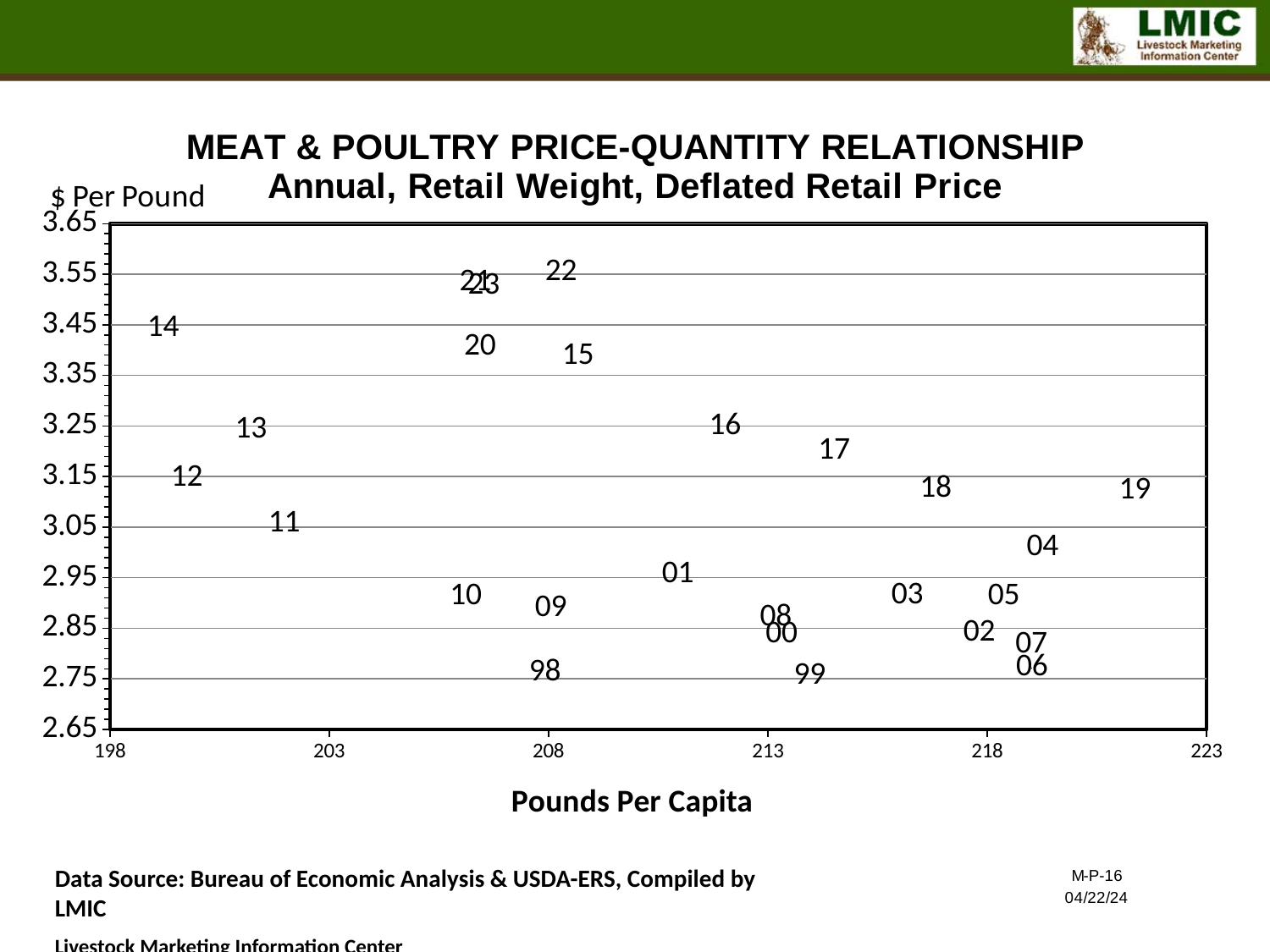
Is the $ Per Pound value for the point labeled 04 greater or less than 3.05? less Is the Pounds Per Capita value for the point labeled 17 greater or less than 213? greater What is the label of the x axis? Pounds Per Capita Is the $ Per Pound value for the point labeled 20 greater or less than 3.35? greater What is the title of the chart? MEAT & POULTRY PRICE-QUANTITY RELATIONSHIP Annual, Retail Weight, Deflated Retail Price Which point has the highest Pounds Per Capita value? 19 Which point has a higher $ Per Pound value, the one labeled 14 or the one labeled 11? 14 What kind of chart is shown on the slide? Scatter chart